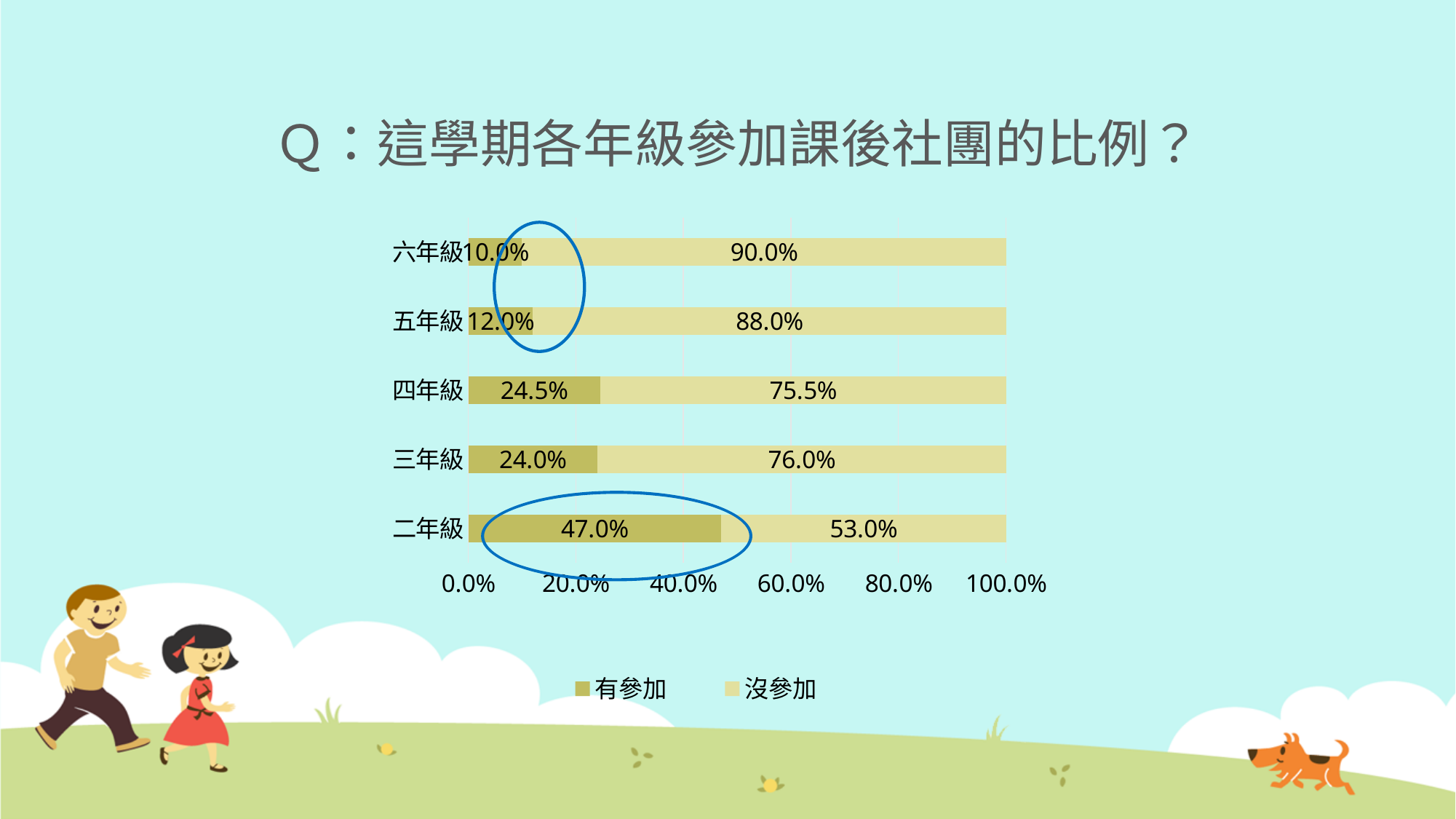
Which is larger, the 沒參加 value for 五年級 or for 三年級? 五年級 What is the value of 有參加 for 二年級? 47.0% Which grade has the lowest 有參加 value? 六年級 What is the value of 沒參加 for 六年級? 90.0% What is the total of the stacked bar for 四年級? 100.0% What is the value of 沒參加 for 四年級? 75.5% What is the value of 有參加 for 五年級? 12.0% What kind of chart is shown on the slide? Stacked bar chart How many series does the legend list? 2 Which grade has the highest 有參加 value? 二年級 How many grade categories are shown in the chart? 5 What is the difference between the 有參加 values for 二年級 and 三年級? 23.0%